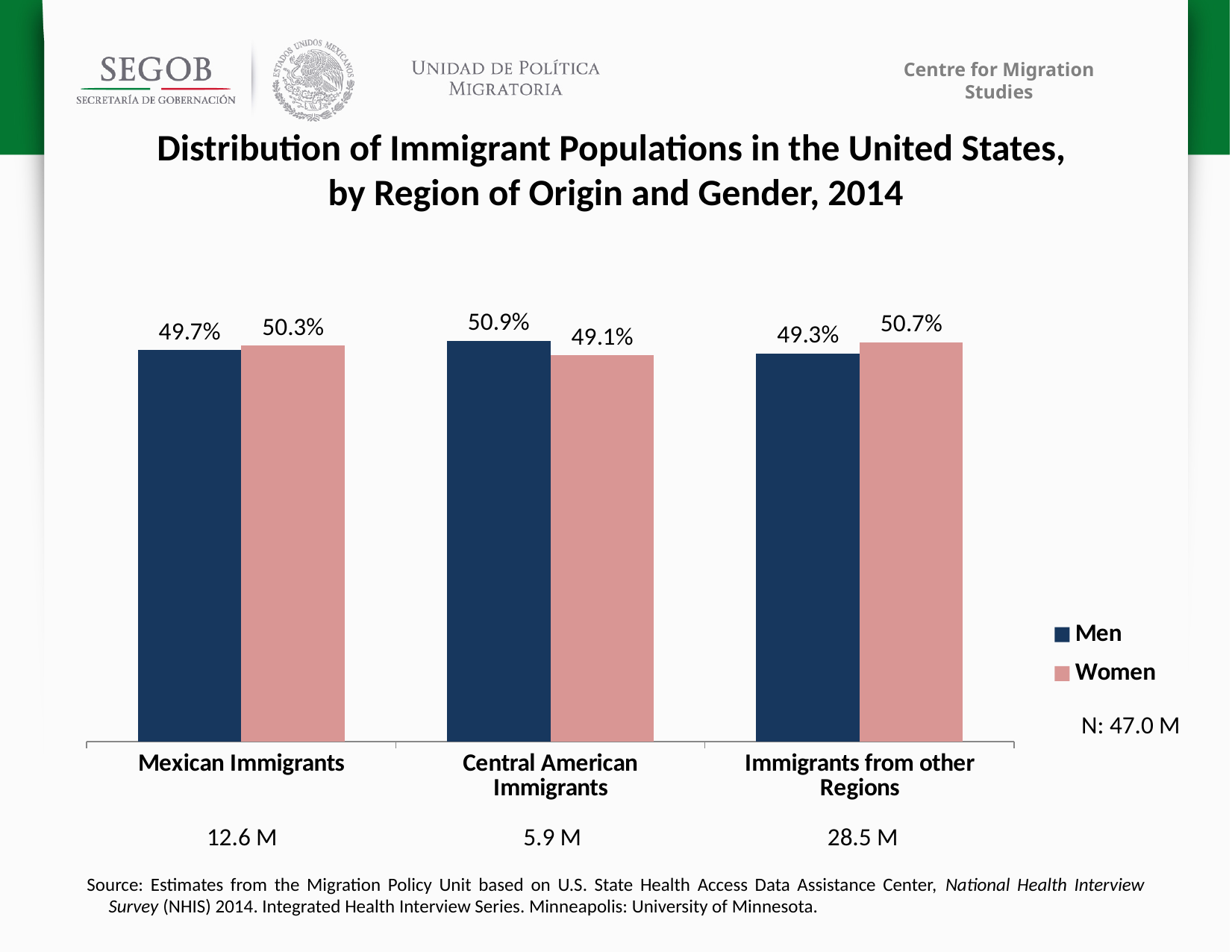
Which region of origin has the lowest share of women? Central American Immigrants What kind of chart is shown on the slide? Bar chart How many regions of origin are shown on the x axis? 3 What is the value for Women among Immigrants from other Regions? 50.7% What total population size (N) is noted on the chart? 47.0 M What percentage of Central American Immigrants are men? 50.9% Which region of origin has the highest share of men? Central American Immigrants What is the difference between the Men and Women percentages for Central American Immigrants? 1.8% How many series does the legend list? 2 For Mexican Immigrants, is the share of men or women larger? Women What percentage of Mexican Immigrants are women? 50.3% What is the value for Men among Immigrants from other Regions? 49.3%